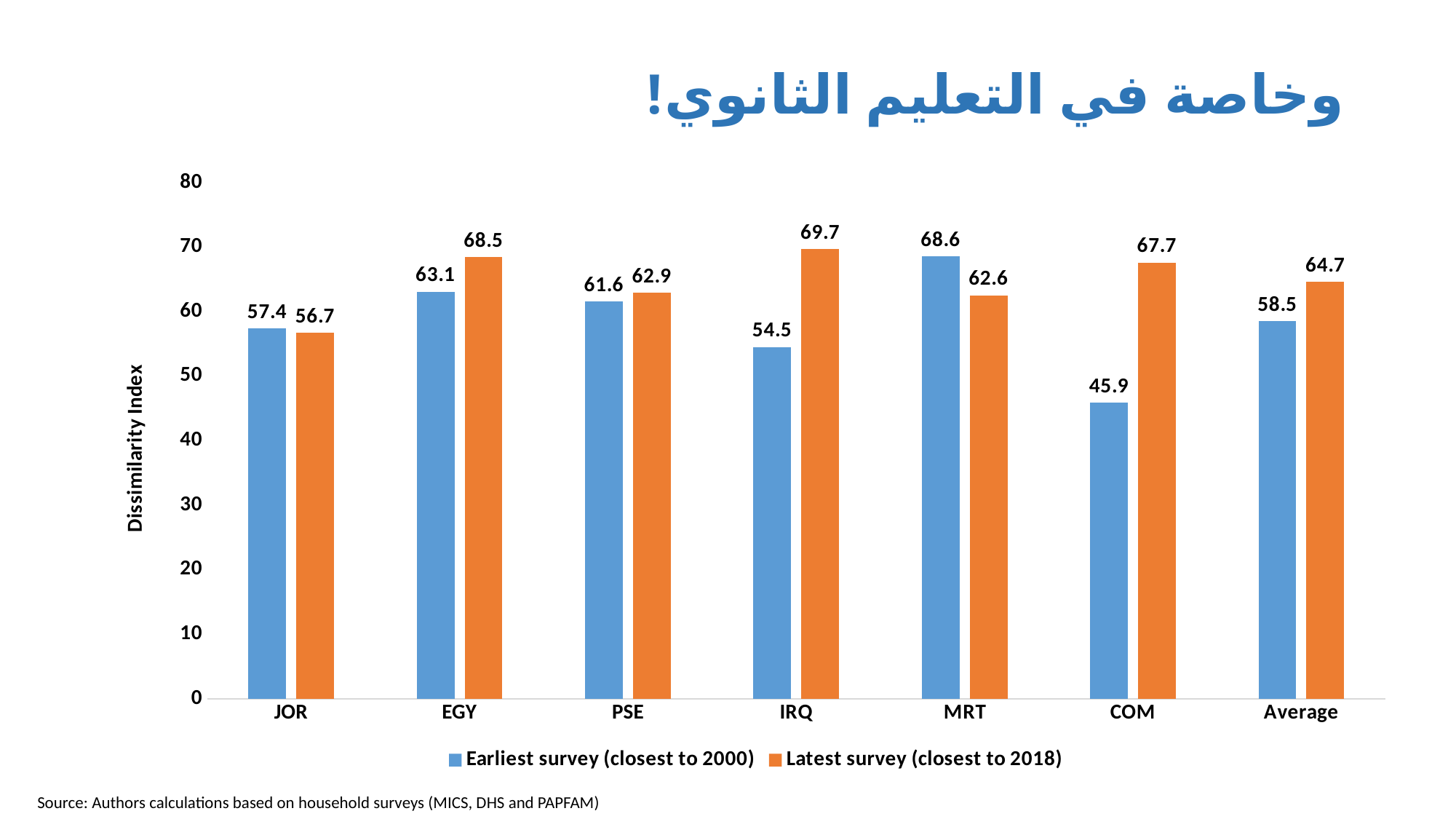
Which category has the lowest Earliest survey (closest to 2000) value? COM How many series does the legend list? 2 What is the difference between the Latest survey and Earliest survey values for COM? 21.8 What is the Latest survey (closest to 2018) value for the Average category? 64.7 Is the Earliest survey (closest to 2000) value for IRQ greater or less than 60? less What is the label of the vertical axis? Dissimilarity Index What kind of chart is shown on the slide? bar chart How many categories are shown on the x axis? 7 For MRT, which is larger: the Earliest survey (closest to 2000) value or the Latest survey (closest to 2018) value? Earliest survey (closest to 2000) What is the Latest survey (closest to 2018) value for IRQ? 69.7 What is the Earliest survey (closest to 2000) value for EGY? 63.1 Which category has the highest Latest survey (closest to 2018) value? IRQ